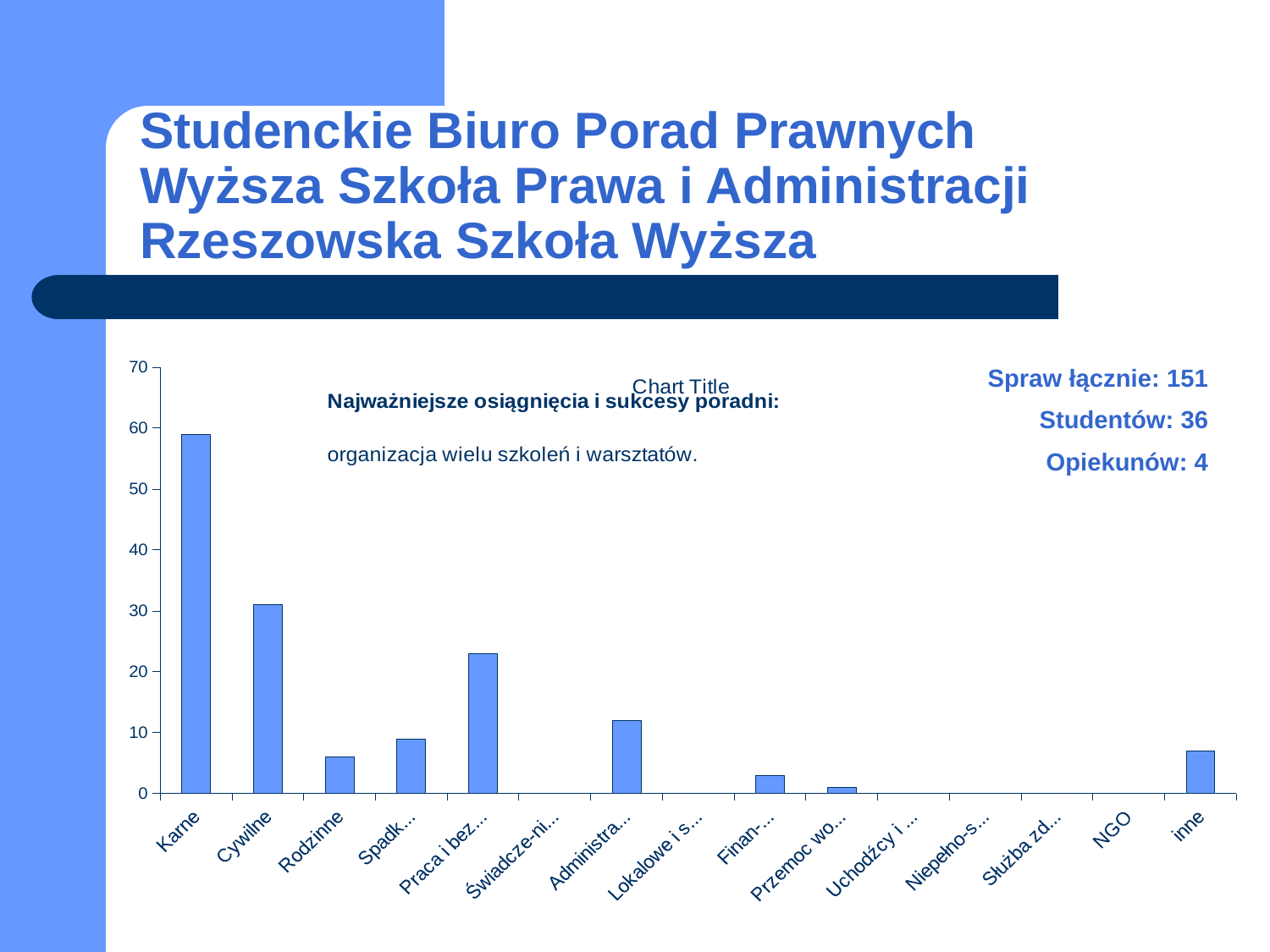
Which category has the highest bar in the chart? Karne How many categories are shown on the x axis of the chart? 15 What is the title shown on the chart? Chart Title Which is larger, the value for Cywilne or the value for Praca i bez...? Cywilne Which is larger, the value for Praca i bez... or the value for Administra...? Praca i bez... Is the value for inne greater or less than 10? less What kind of chart is shown on the slide? bar chart Is the value for Karne greater or less than 50? greater Is the value for Administra... greater or less than 20? less Which is larger, the value for Karne or the value for Cywilne? Karne